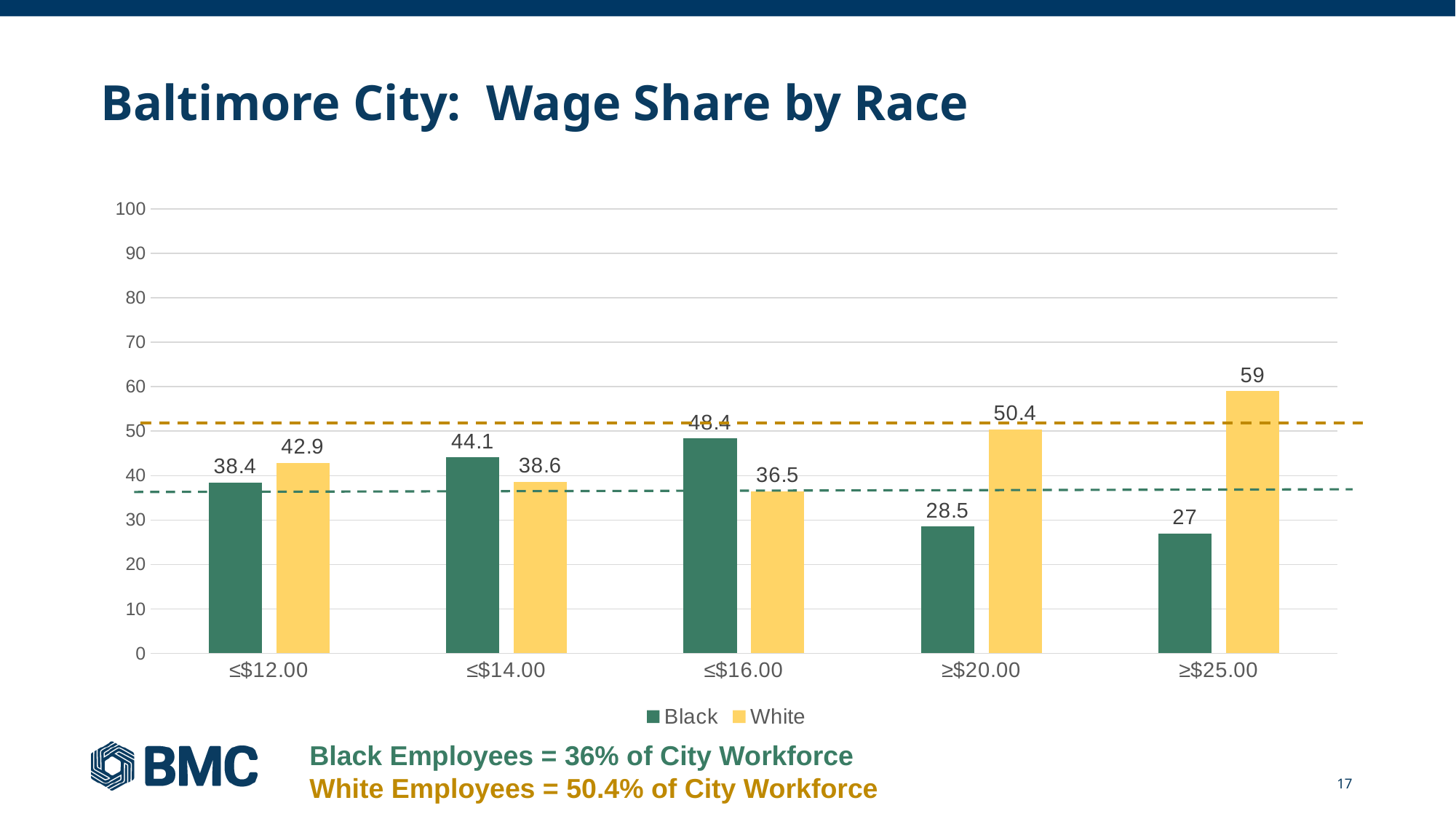
What kind of chart is shown on the slide? bar chart In the ≤$14.00 category, which series has the larger value, Black or White? Black Which wage category has the highest value for the Black series? ≤$16.00 What is the value for White in the ≤$16.00 category? 36.5 How many wage categories are shown on the x axis? 5 What is the value for White in the ≥$25.00 category? 59 How many series does the legend list? 2 What is the difference between the White and Black values in the ≥$20.00 category? 21.9 Is the value for Black in the ≥$25.00 category greater or less than 30? less Which wage category has the lowest value for the White series? ≤$16.00 What is the value for Black in the ≤$12.00 category? 38.4 What is the title of the slide? Baltimore City: Wage Share by Race